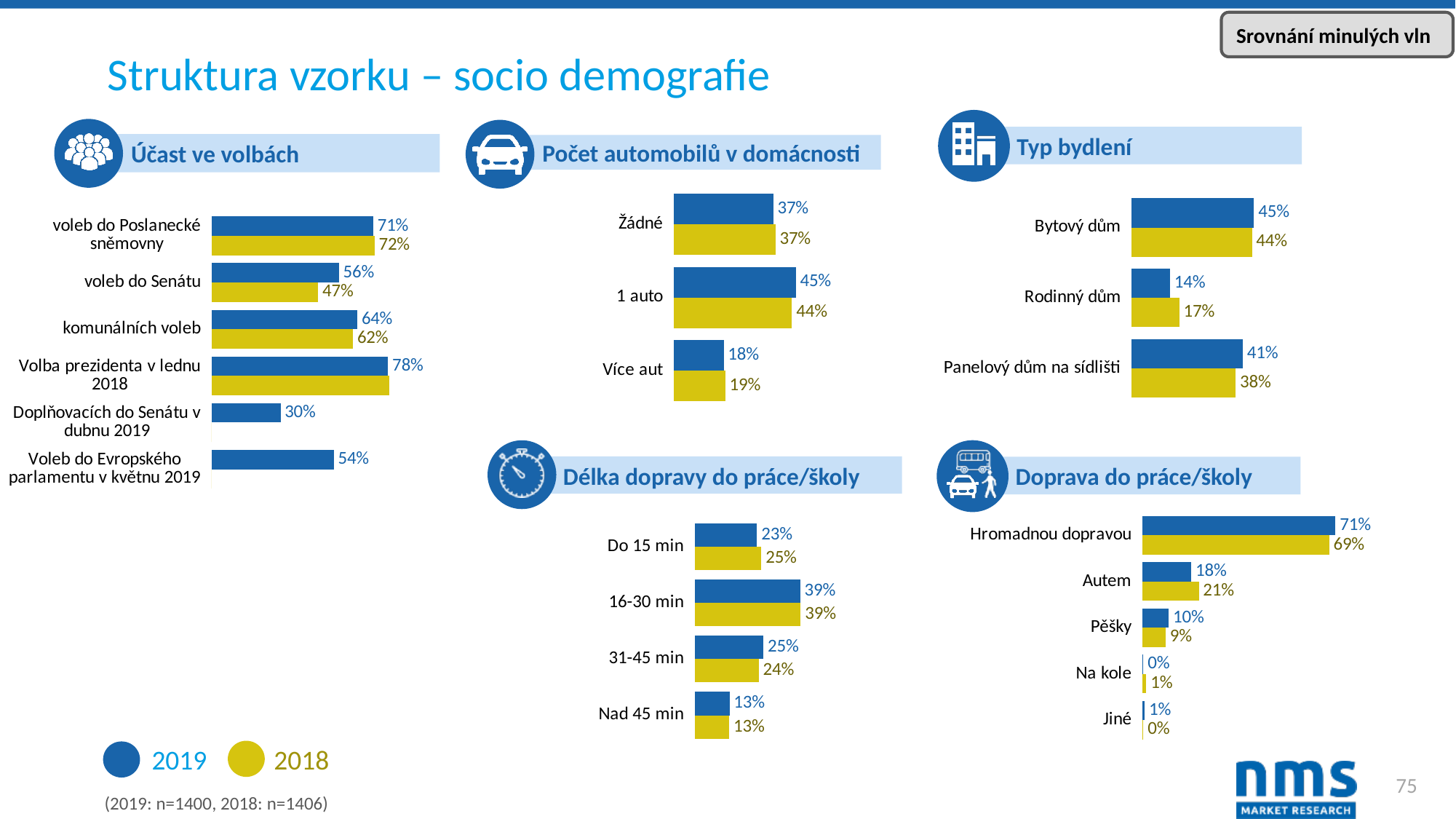
In the 'Účast ve volbách' chart, what is the 2018 value for 'voleb do Senátu'? 47% In the 'Doprava do práce/školy' chart, what is the 2019 value for 'Hromadnou dopravou'? 71% In the 'Počet automobilů v domácnosti' chart, what is the difference between the 2019 and 2018 values for 'Více aut'? 1% How many categories does the 'Délka dopravy do práce/školy' chart show? 4 How many series does the legend at the bottom of the slide list? 2 In the 'Doprava do práce/školy' chart, what is the difference between the 2018 and 2019 values for 'Autem'? 3% In the 'Délka dopravy do práce/školy' chart, what is the 2018 value for 'Do 15 min'? 25% In the 'Účast ve volbách' chart, what is the 2019 value for 'Volba prezidenta v lednu 2018'? 78% In the 'Typ bydlení' chart, which category has the lowest 2019 value? Rodinný dům In the 'Počet automobilů v domácnosti' chart, which category has the highest 2019 value? 1 auto In the 'Typ bydlení' chart, is the 2019 value for 'Bytový dům' larger or smaller than the 2019 value for 'Panelový dům na sídlišti'? larger What kind of chart is the 'Účast ve volbách' chart? bar chart